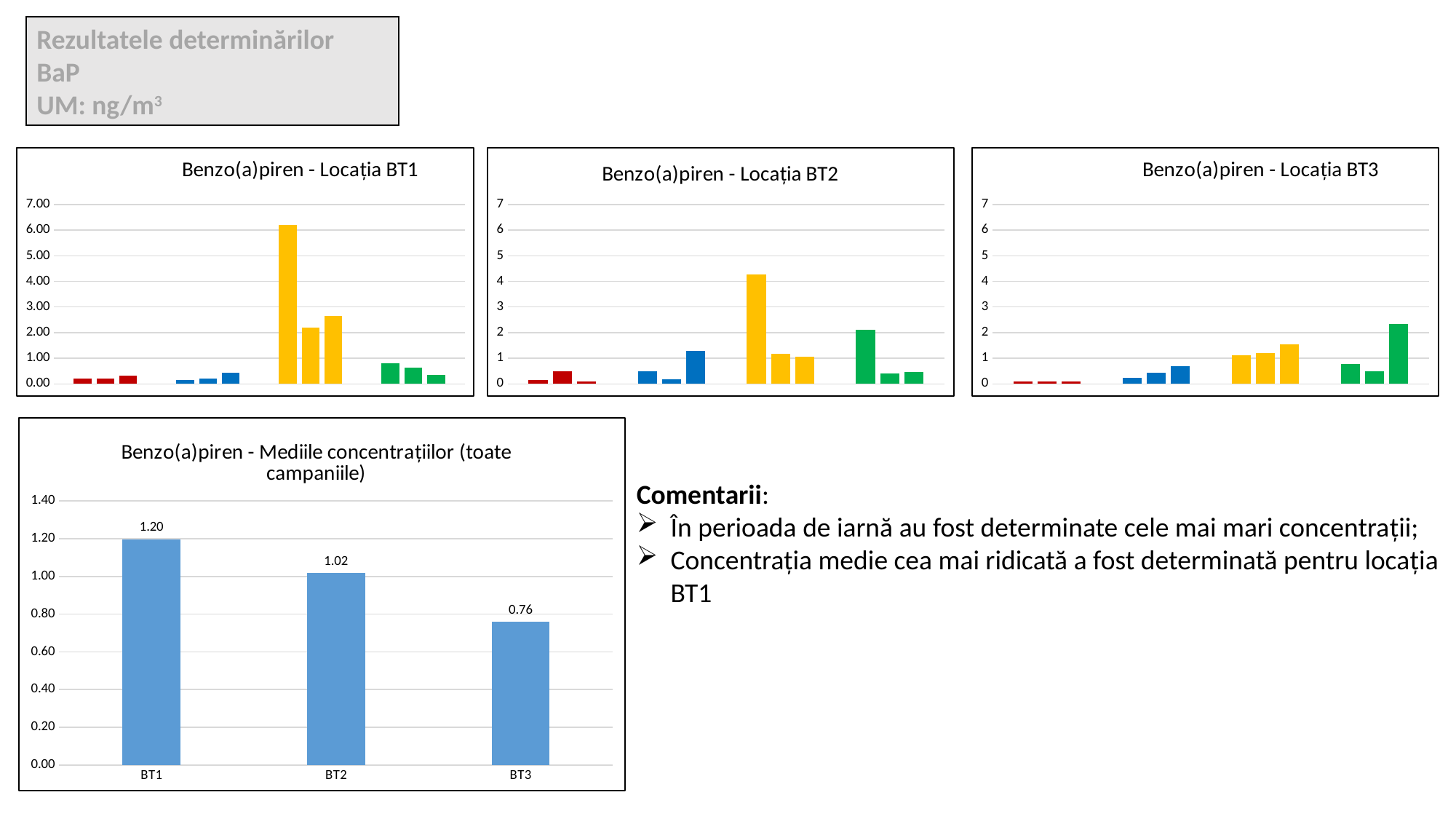
In the chart 'Benzo(a)piren - Mediile concentrațiilor (toate campaniile)', what is the value for BT2? 1.02 In the chart 'Benzo(a)piren - Locația BT3', is the tallest bar greater or less than 3? less In the chart 'Benzo(a)piren - Mediile concentrațiilor (toate campaniile)', which location has the highest value? BT1 In the chart 'Benzo(a)piren - Mediile concentrațiilor (toate campaniile)', what is the value for BT3? 0.76 In the chart 'Benzo(a)piren - Locația BT1', is the tallest bar greater or less than 5.00? greater How many locations are shown in the chart 'Benzo(a)piren - Mediile concentrațiilor (toate campaniile)'? 3 In the chart 'Benzo(a)piren - Mediile concentrațiilor (toate campaniile)', what is the value for BT1? 1.20 What kind of chart is 'Benzo(a)piren - Locația BT1'? bar chart In the chart 'Benzo(a)piren - Mediile concentrațiilor (toate campaniile)', which location has the lowest value? BT3 In the chart 'Benzo(a)piren - Mediile concentrațiilor (toate campaniile)', which is larger, the value for BT2 or the value for BT3? BT2 In the chart 'Benzo(a)piren - Mediile concentrațiilor (toate campaniile)', do the values rise or fall from BT1 to BT3? fall In the chart 'Benzo(a)piren - Mediile concentrațiilor (toate campaniile)', what is the difference between the values for BT1 and BT3? 0.44